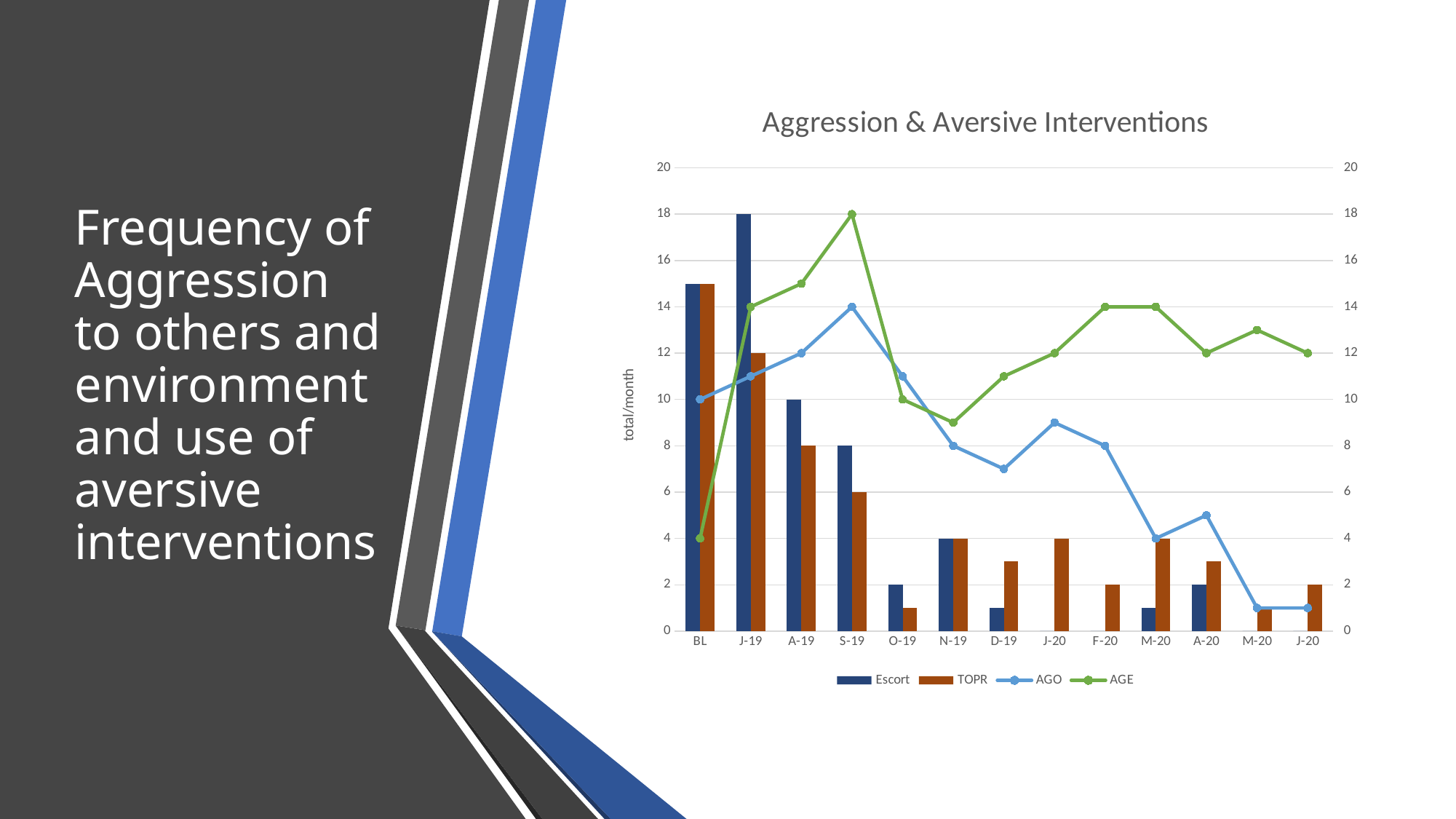
What is the Escort value for J-19? 18 What is the AGE value for S-19? 18 How many series does the chart legend list? 4 What is the difference between the Escort values for J-19 and A-19? 8 What is the title of the chart? Aggression & Aversive Interventions What is the AGO value for BL? 10 In which category does the AGE line reach its highest value? S-19 How many categories are shown on the x axis of the chart? 13 Is the Escort value for BL greater or less than 14? greater Does the AGO line generally rise or fall from BL to J-20? fall What kind of chart is shown on the slide? Combined bar and line chart In which category is the Escort bar highest? J-19